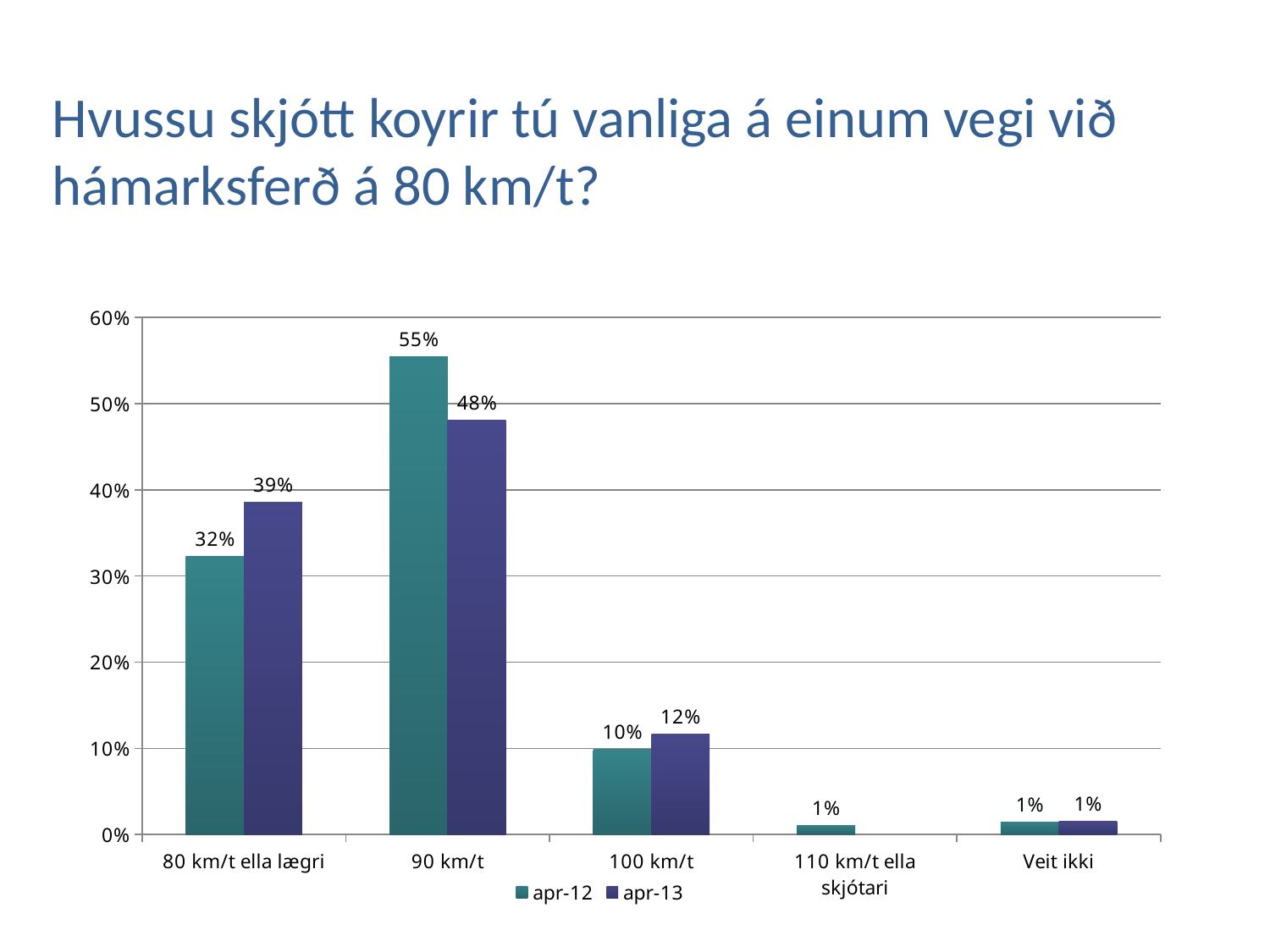
What is the difference between the apr-13 and apr-12 values for 80 km/t ella lægri? 7% Which is larger for 100 km/t, the apr-12 value or the apr-13 value? apr-13 What is the apr-13 value for 100 km/t? 12% Which category has the highest apr-12 value? 90 km/t What kind of chart is shown on the slide? bar chart Which category has the highest apr-13 value? 90 km/t How many series does the legend list? 2 How many categories are shown on the x axis? 5 What is the apr-12 value for 90 km/t? 55% What is the apr-13 value for 80 km/t ella lægri? 39% What is the apr-12 value for 110 km/t ella skjótari? 1% What is the difference between the apr-12 and apr-13 values for 90 km/t? 7%